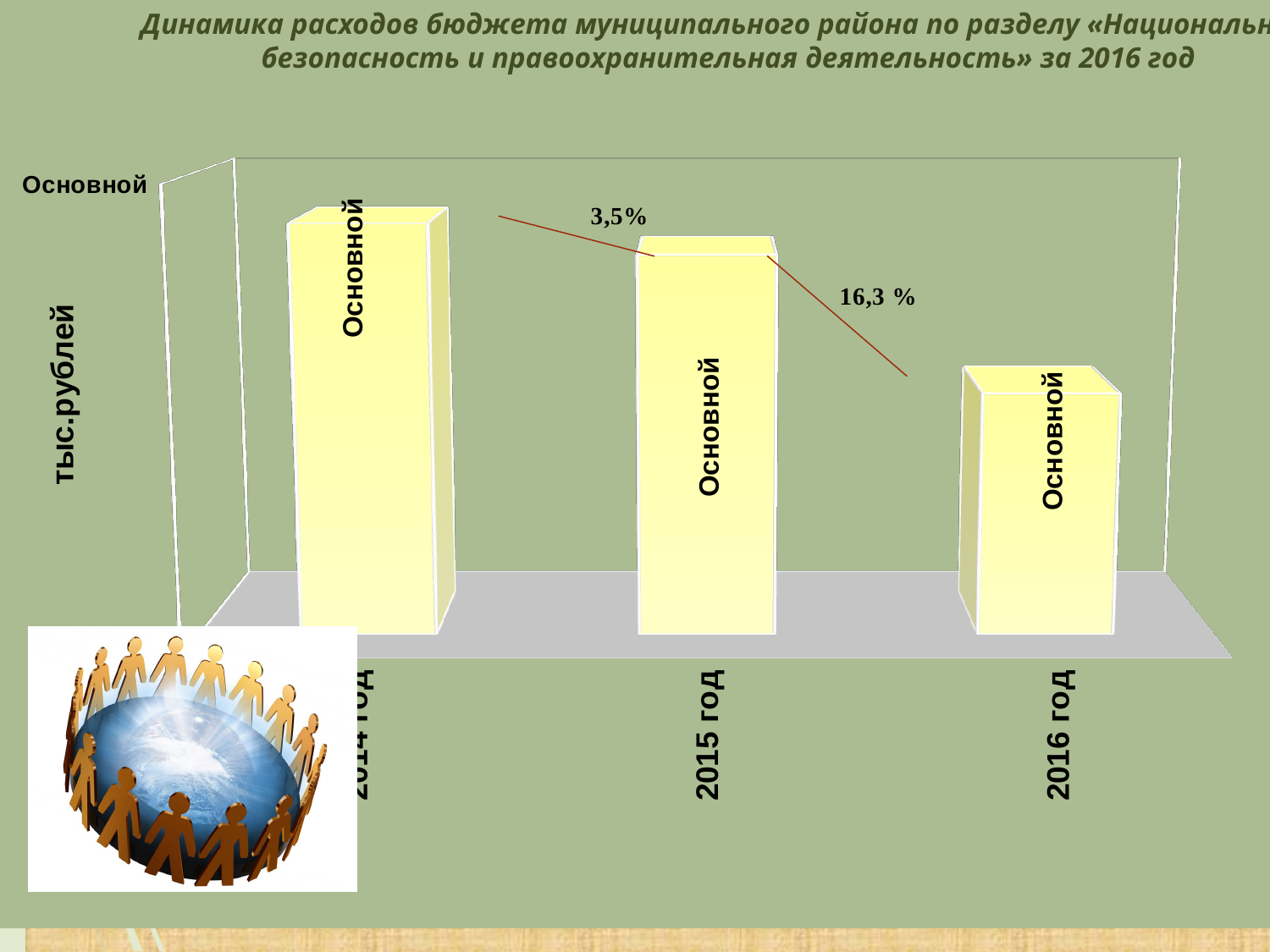
Which is larger, the bar for 2014 год or the bar for 2015 год? 2014 год Which is larger, the bar for 2015 год or the bar for 2016 год? 2015 год What kind of chart is shown on the slide? bar chart What percentage change is annotated between the 2015 and 2016 bars? 16,3 % Which year has the highest bar in the chart? 2014 год Which year has the lowest bar in the chart? 2016 год Do the values rise or fall from 2014 to 2016 along the x axis? fall How many bars (years) are plotted in the chart? 3 What unit is given on the vertical axis label of the chart? тыс.рублей What colour are the bars in the chart? yellow What percentage change is annotated between the 2014 and 2015 bars? 3,5%